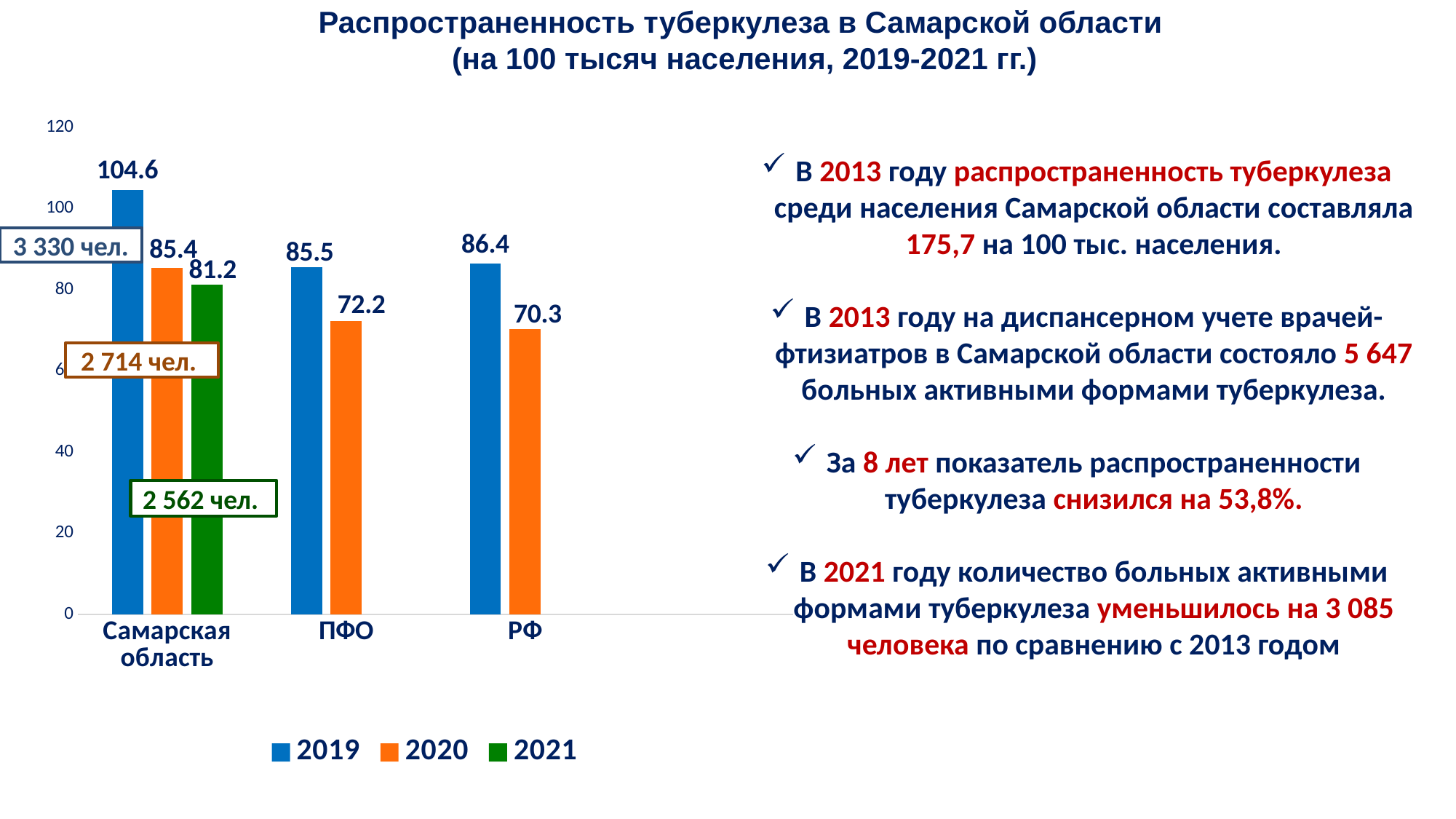
What is the 2020 value for ПФО? 72.2 What is the 2019 value for Самарская область? 104.6 Which is larger: the 2020 value for ПФО or the 2020 value for РФ? ПФО How many categories are shown on the x axis? 3 How many series does the legend list? 3 Which category has the lowest 2020 value? РФ Which category has the highest 2019 value? Самарская область What is the 2021 value for Самарская область? 81.2 What is the 2020 value for РФ? 70.3 What is the difference between the 2019 and 2020 values for Самарская область? 19.2 Do the values for Самарская область rise or fall from 2019 to 2021? Fall What kind of chart is shown on the slide? Bar chart